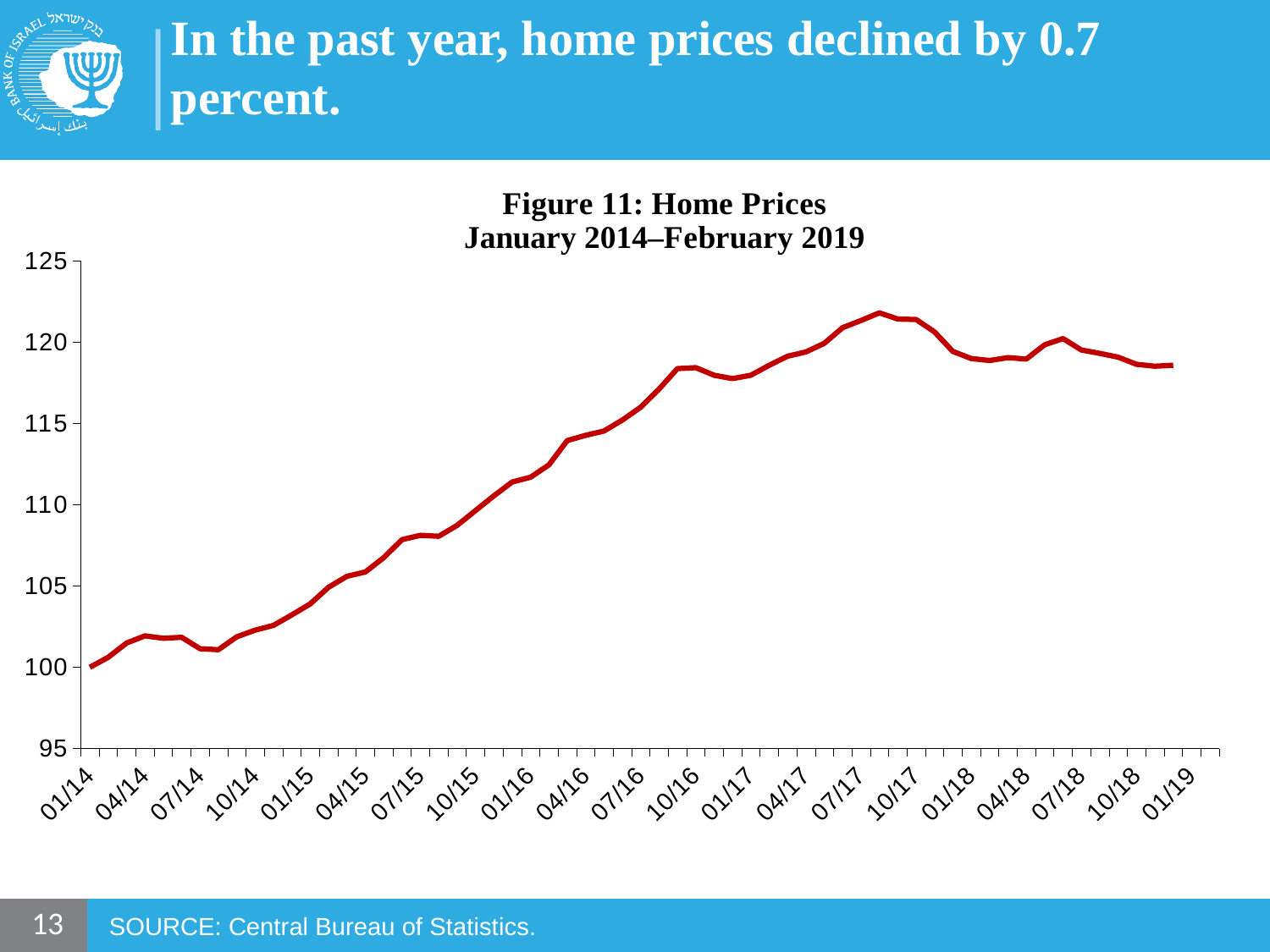
Which is larger, the value at 10/17 or the value at 01/18? 10/17 Is the value at 07/15 greater or less than 110? less In which year does the line reach its highest point? 2017 Does the line generally rise or fall between 01/14 and 07/17? rise What is the title of the chart? Figure 11: Home Prices January 2014–February 2019 Is the value at 04/14 greater or less than 100? greater Is the value at 10/18 greater or less than 120? less What kind of chart is shown on the slide? line chart What is the value of the home price index at 01/14? 100 Which is larger, the value at 07/16 or the value at 07/17? 07/17